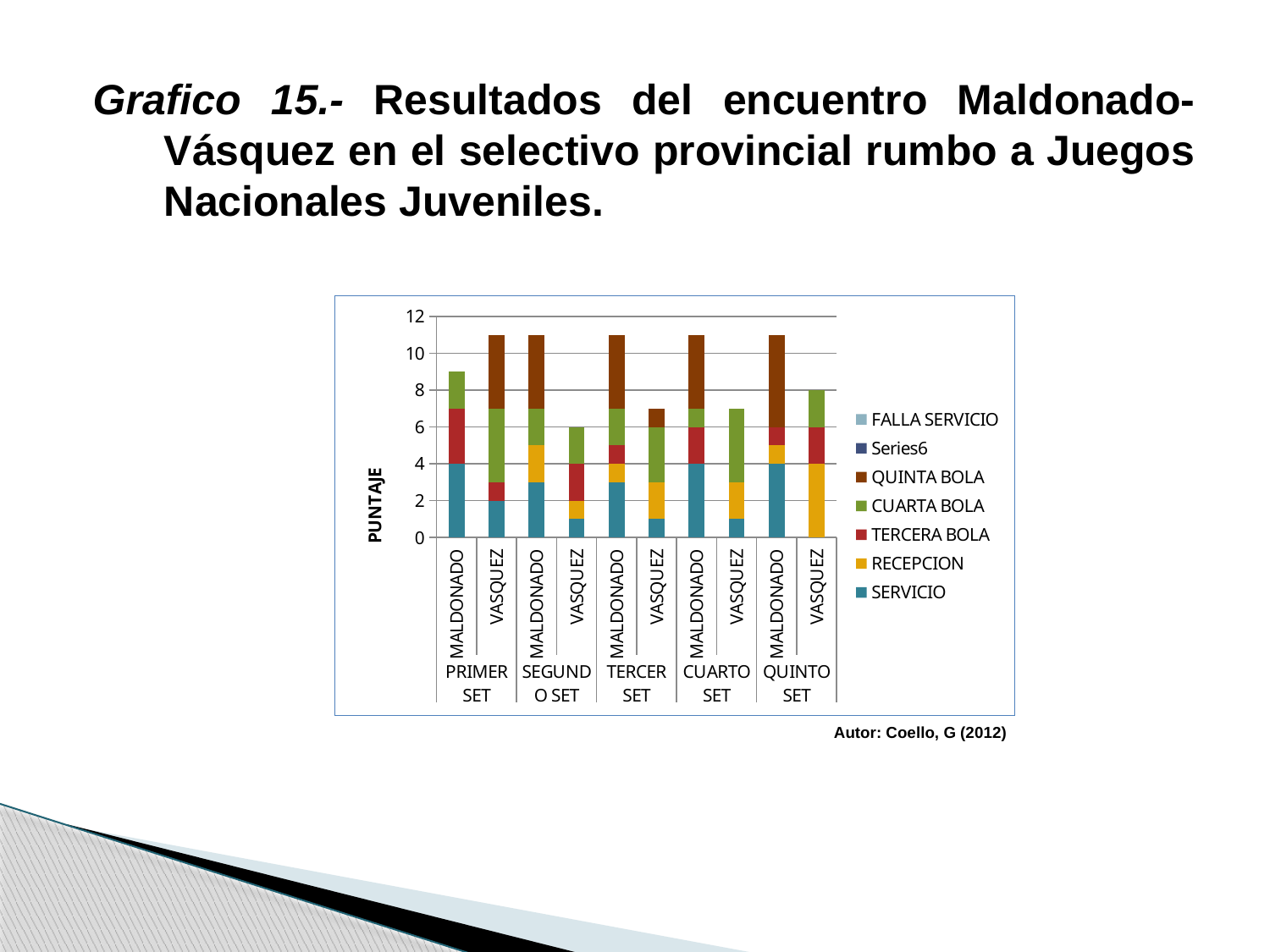
How many sets are shown along the x axis of the chart? 5 Is the total bar height for MALDONADO in PRIMER SET greater or less than 8? greater How many series does the chart legend list? 7 In PRIMER SET, what is the SERVICIO value for MALDONADO? 4 How many bars are plotted in the chart? 10 What is the title of the vertical axis of the chart? PUNTAJE Which legend entry is shown in green in the chart? CUARTA BOLA In SEGUNDO SET, which player has the taller total bar, MALDONADO or VASQUEZ? MALDONADO Which is taller, the VASQUEZ bar in PRIMER SET or the VASQUEZ bar in SEGUNDO SET? VASQUEZ in PRIMER SET What kind of chart is shown on the slide? Stacked bar chart Is the total bar height for VASQUEZ in PRIMER SET greater or less than 10? greater Is the total bar height for VASQUEZ in SEGUNDO SET greater or less than 8? less